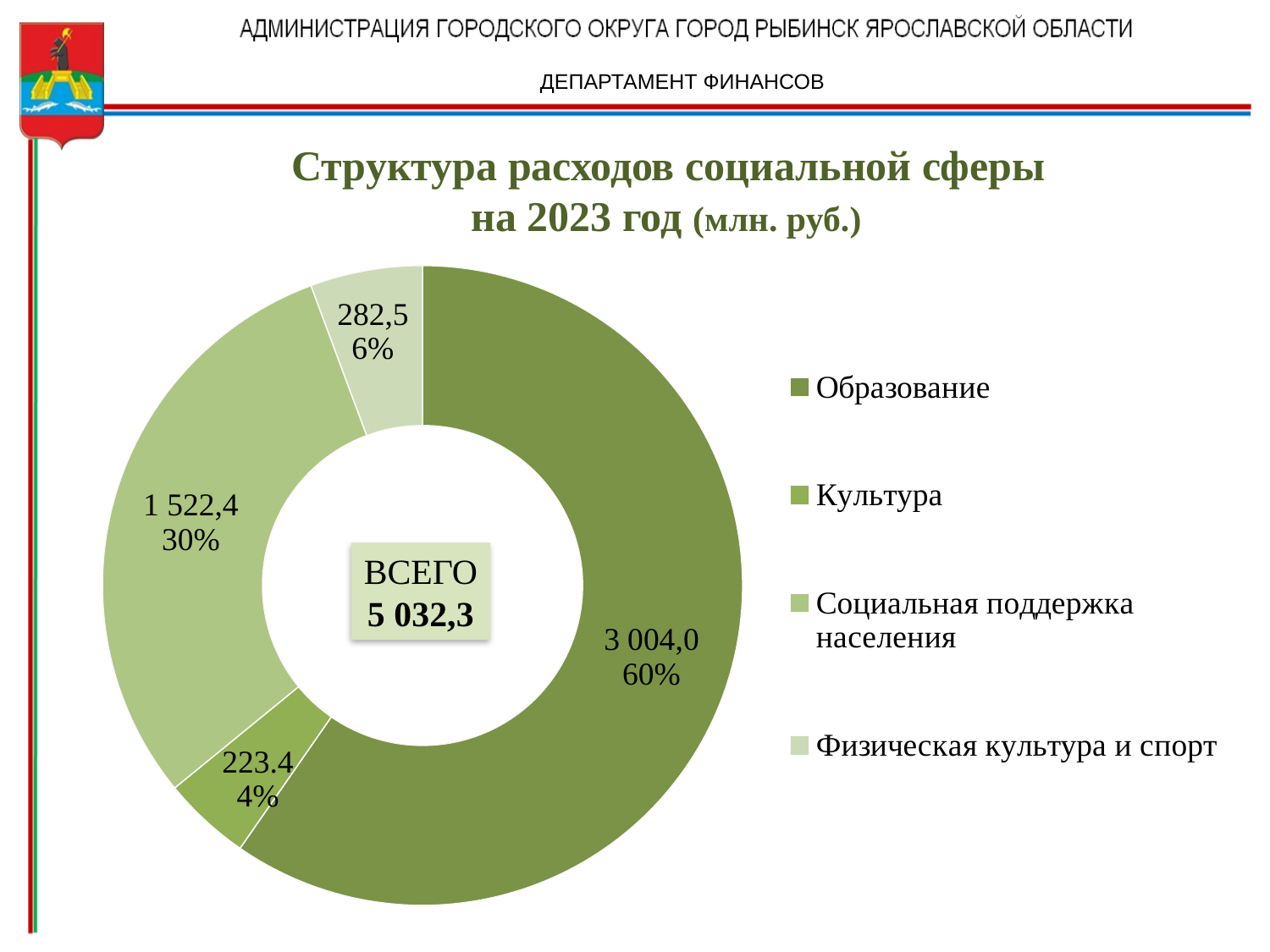
What type of chart is shown on the slide? Doughnut (pie) chart Which category has the largest share of the chart? Образование What total (ВСЕГО) is shown in the centre of the chart? 5 032,3 What share of the chart does Социальная поддержка населения represent? 30% What is the value for Физическая культура и спорт? 282,5 What share of the chart does Физическая культура и спорт represent? 6% How many categories does the chart show? 4 Which category has the smallest share of the chart? Культура What is the value for Культура? 223.4 Which is larger: the value for Физическая культура и спорт or the value for Культура? Физическая культура и спорт What is the value for Социальная поддержка населения? 1 522,4 What is the value for Образование? 3 004,0